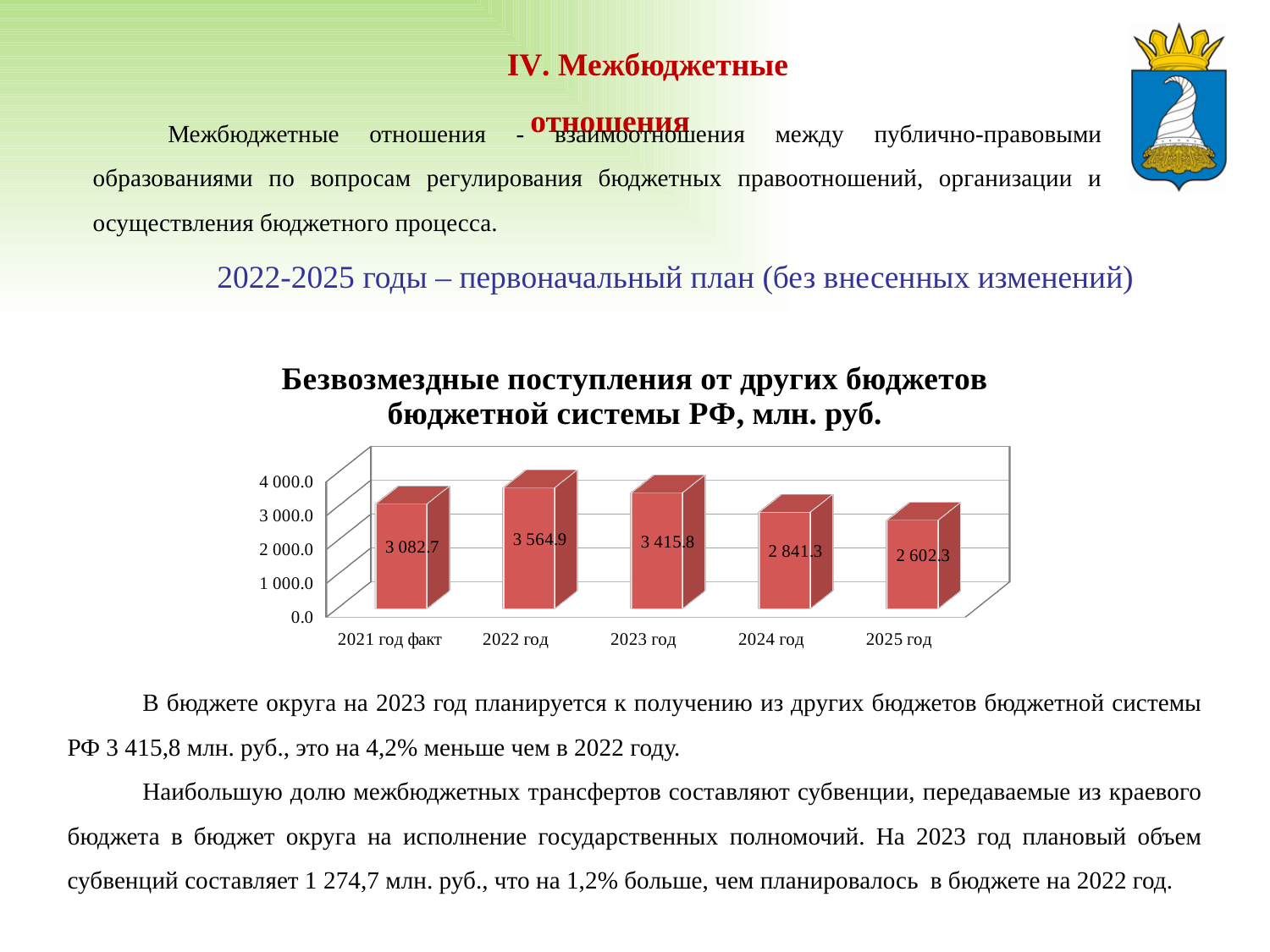
What is the value for 2021 год факт? 3 082.7 Which is larger, the value for 2021 год факт or the value for 2023 год? 2023 год What is the difference between the values for 2022 год and 2023 год? 149.1 Do the values rise or fall from 2022 год to 2025 год? fall What is the value for 2024 год? 2 841.3 What is the difference between the values for 2024 год and 2025 год? 239.0 What is the value for 2025 год? 2 602.3 What is the value for 2022 год? 3 564.9 Which category has the highest value? 2022 год Which category has the lowest value? 2025 год What kind of chart is this? bar chart How many categories are shown on the x axis? 5